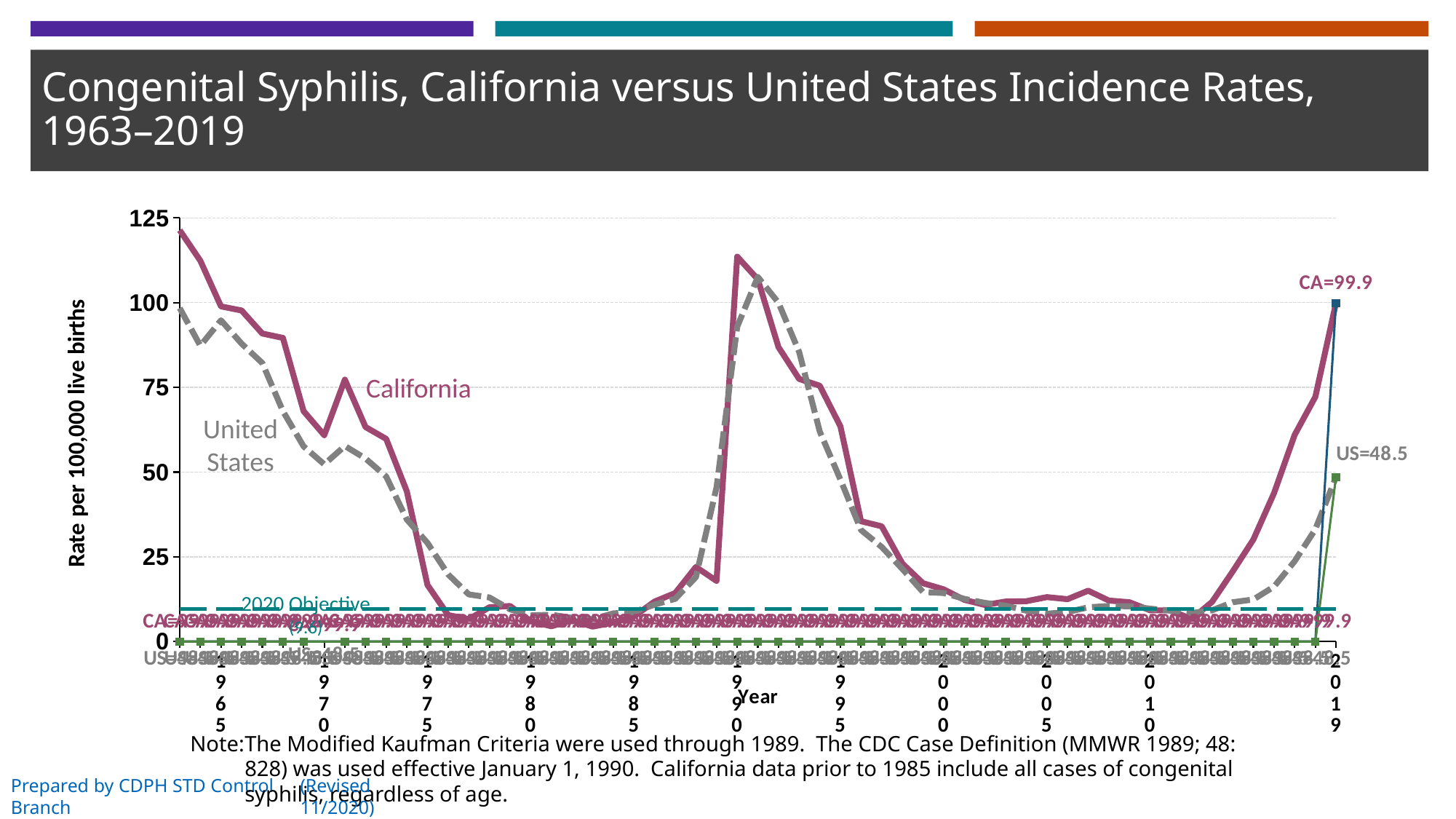
Is the California rate in 1965 greater or less than 75? greater What kind of chart is shown on the slide? line chart What is the title of the y axis? Rate per 100,000 live births Does the California rate rise or fall between 2010 and 2019? rise What is the United States congenital syphilis rate in 2019? 48.5 What is the California congenital syphilis rate in 2019? 99.9 What is the title of the x axis? Year Does the California rate rise or fall between 1963 and 1975? fall In 2019, which has the higher rate, California or the United States? California What is the difference between the California and United States rates in 2019? 51.4 Is the United States rate in 2000 greater or less than 25? less Is the United States rate in 1980 greater or less than 25? less